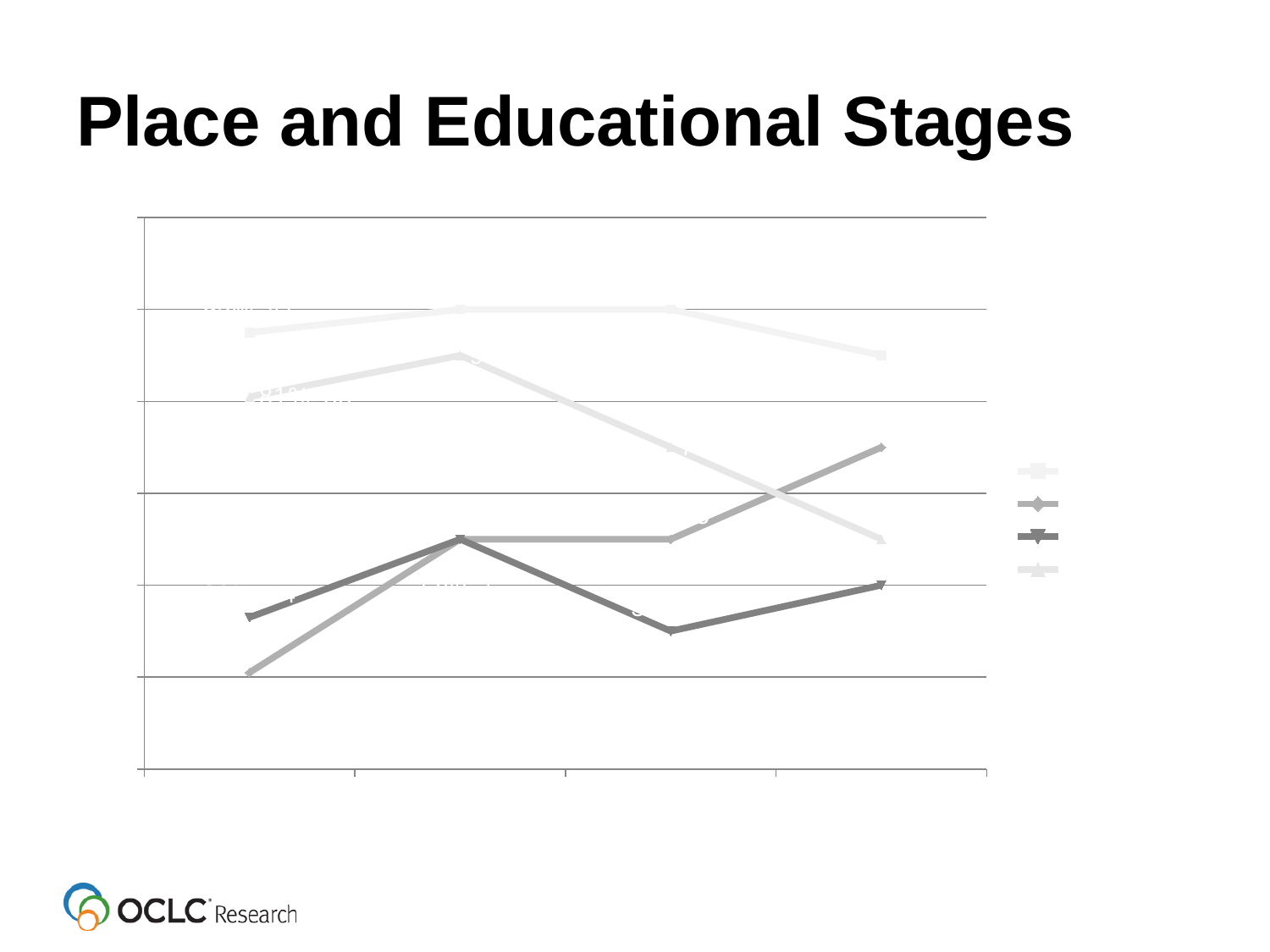
How many series does the legend list? 4 Which line is lowest at the last x-axis point? the darkest line Does the line with diamond markers end higher or lower than where it starts? higher How many data points does each line have along the x axis? 4 What is the title of the slide containing the chart? Place and Educational Stages Which line is highest at the first x-axis point: the lightest line or the darkest line? the lightest line Does the lightest line end higher or lower than where it starts? lower What kind of chart is shown on the slide? line chart